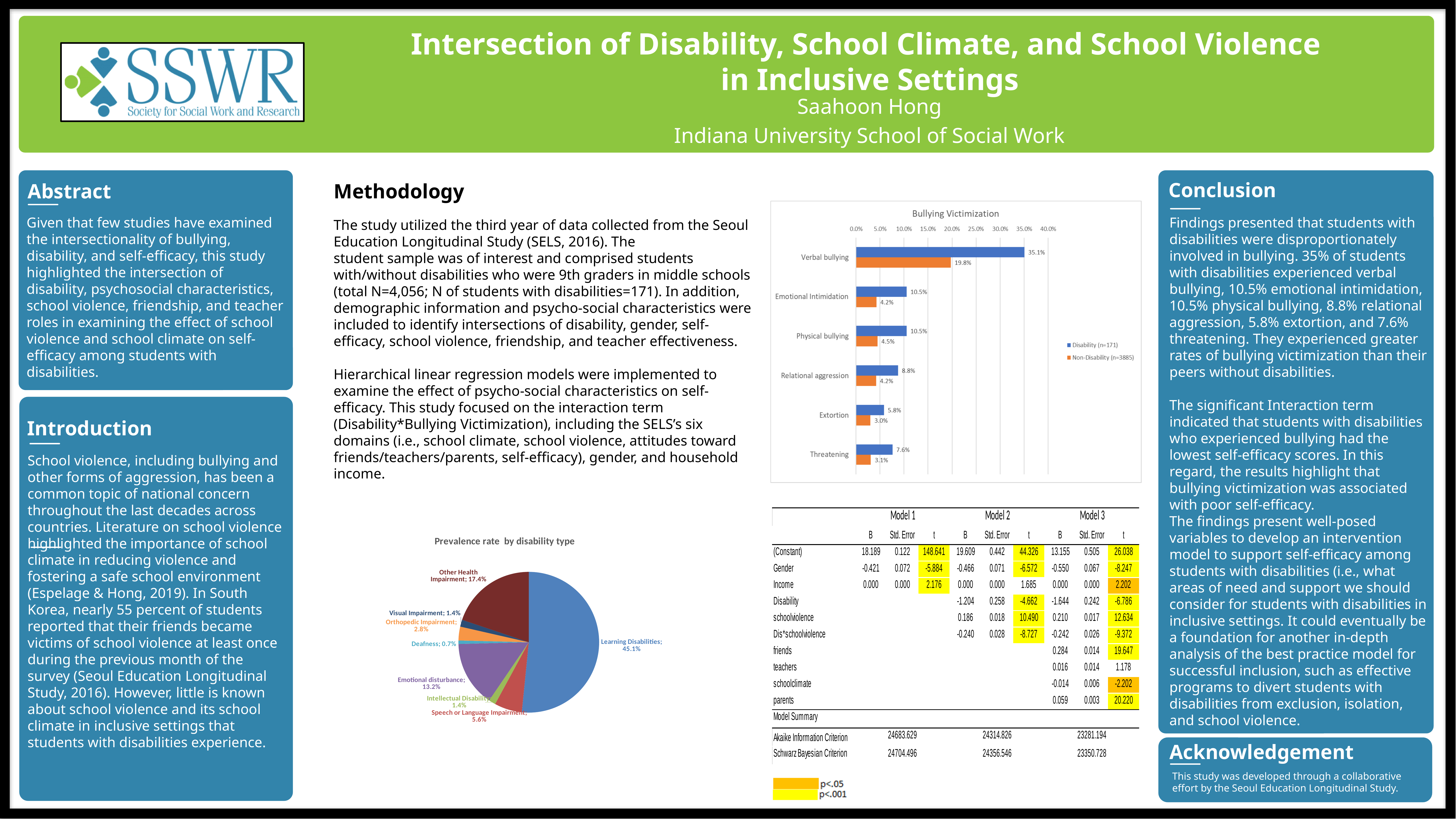
In the Bullying Victimization chart, what is the difference between the Disability and Non-Disability values for Verbal bullying? 15.3% In the Bullying Victimization chart, is the Disability value for Threatening larger or smaller than the Disability value for Relational aggression? smaller How many slices does the Prevalence rate by disability type pie chart have? 8 In the Prevalence rate by disability type chart, which disability type has the smallest slice? Deafness What kind of chart is the Bullying Victimization chart? bar chart In the Bullying Victimization chart, what is the Non-Disability (n=3885) value for Extortion? 3.0% How many series does the legend of the Bullying Victimization chart list? 2 In the Bullying Victimization chart, which category has the highest Disability (n=171) value? Verbal bullying In the Bullying Victimization chart, which category has the lowest Disability (n=171) value? Extortion In the Bullying Victimization chart, what is the value for Verbal bullying in the Disability (n=171) series? 35.1% In the Prevalence rate by disability type chart, what share does Learning Disabilities have? 45.1% How many categories are shown in the Bullying Victimization chart? 6